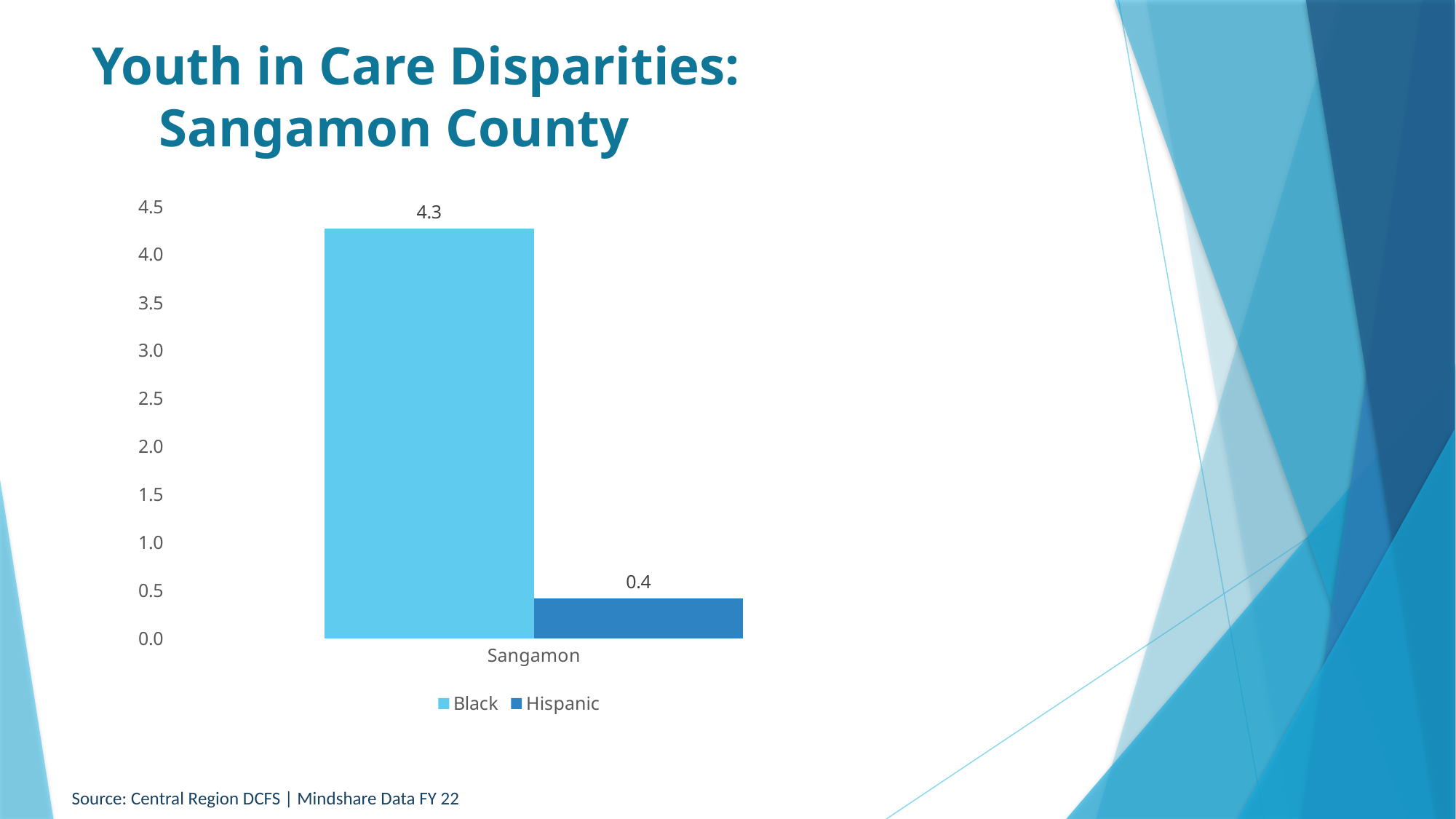
Is the value for Hispanic in Sangamon greater or less than 1.0? less Which series has the higher value for Sangamon, Black or Hispanic? Black How many series does the legend list? 2 What is the highest value shown on the y axis? 4.5 What kind of chart is shown on the slide? Bar chart What is the category label on the x axis? Sangamon What is the value for Hispanic in Sangamon? 0.4 What is the difference between the Black and Hispanic values for Sangamon? 3.9 How many categories are shown on the x axis? 1 Is the value for Black in Sangamon greater or less than 4.0? greater Which series has the lowest value in the chart? Hispanic What is the value for Black in Sangamon? 4.3